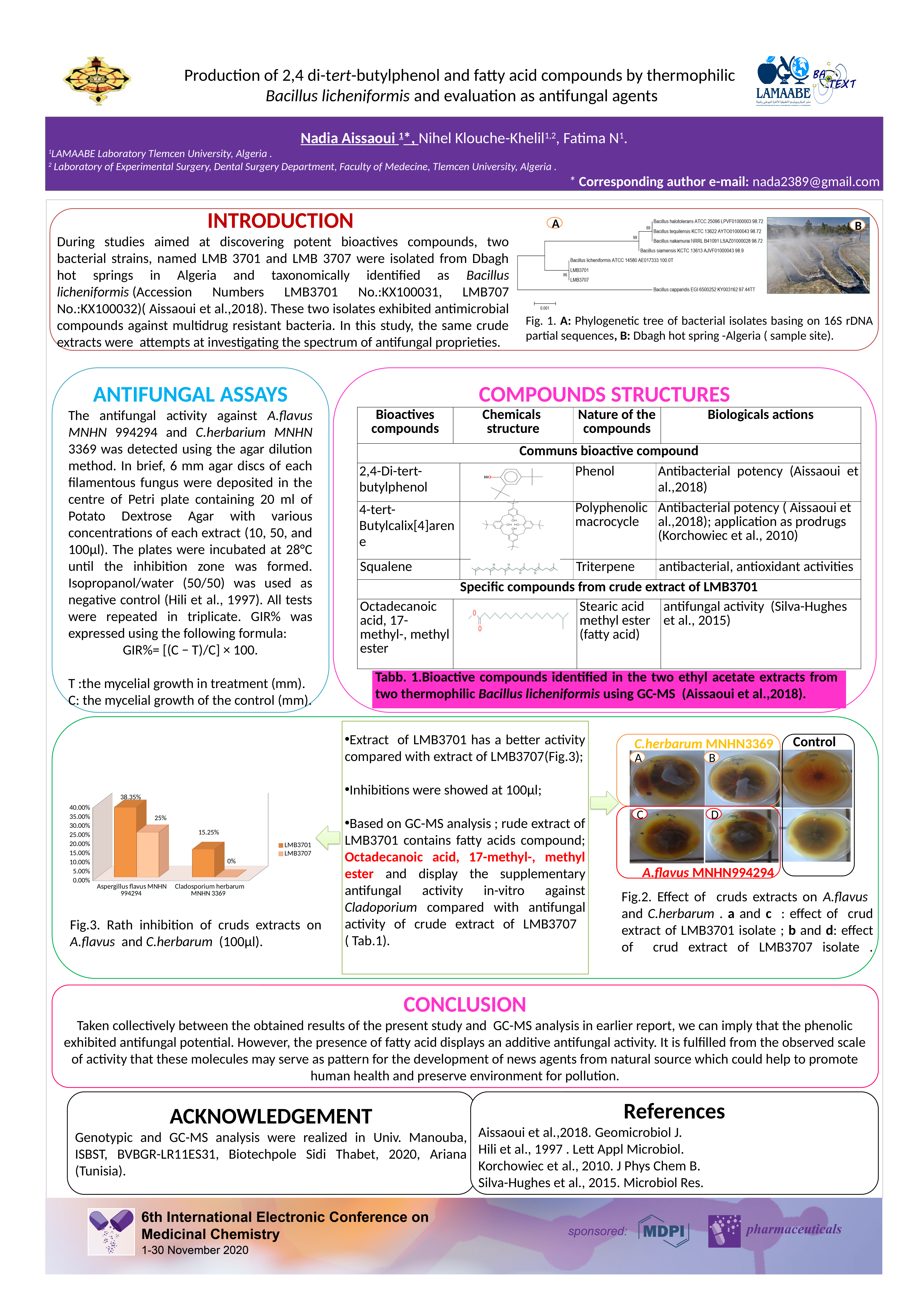
What kind of chart is Fig.3? Bar chart In the Fig.3 bar chart, which series has the highest value overall? LMB3701 What is the value for LMB3707 on Aspergillus flavus MNHN 994294 in the Fig.3 bar chart? 25% In the Fig.3 bar chart, which series and category combination has the lowest value? LMB3707 on Cladosporium herbarum MNHN 3369 What is the highest tick value shown on the y axis of the Fig.3 bar chart? 40.00% How many series does the legend of the Fig.3 chart list? 2 In the Fig.3 bar chart, what is the difference between the LMB3701 and LMB3707 values for Aspergillus flavus MNHN 994294? 13.35% What is the value for LMB3701 on Cladosporium herbarum MNHN 3369 in the Fig.3 bar chart? 15.25% What is the value for LMB3707 on Cladosporium herbarum MNHN 3369 in the Fig.3 bar chart? 0% In the Fig.3 bar chart, which is larger for Cladosporium herbarum MNHN 3369: LMB3701 or LMB3707? LMB3701 How many categories are shown on the x axis of the Fig.3 bar chart? 2 What is the value for LMB3701 on Aspergillus flavus MNHN 994294 in the Fig.3 bar chart? 38.35%